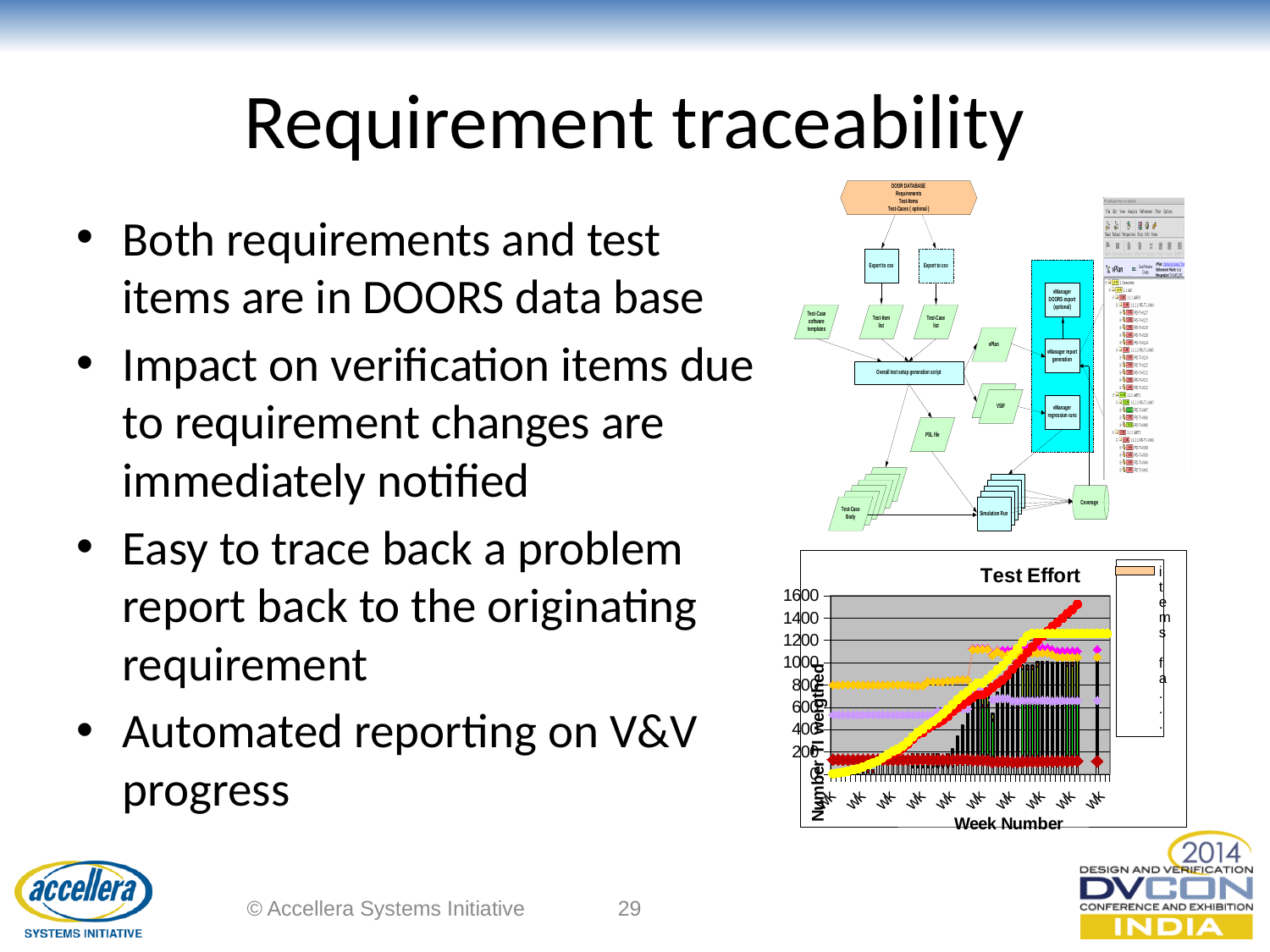
In the Test Effort chart, is the dark red marker series near the bottom greater or less than 400 throughout? less In the Test Effort chart, is the starting value of the purple marker series greater or less than 400? greater What is the x-axis label of the Test Effort chart? Week Number What is the lowest value shown on the y-axis of the Test Effort chart? 0 Does the Test Effort chart plot its data against weeks or months on the x axis? weeks In the Test Effort chart, does the red marker series rise or fall as the week number increases? rise In the Test Effort chart, is the starting value of the purple marker series greater or less than 800? less What is the title of the chart on the slide? Test Effort What is the highest value shown on the y-axis of the Test Effort chart? 1600